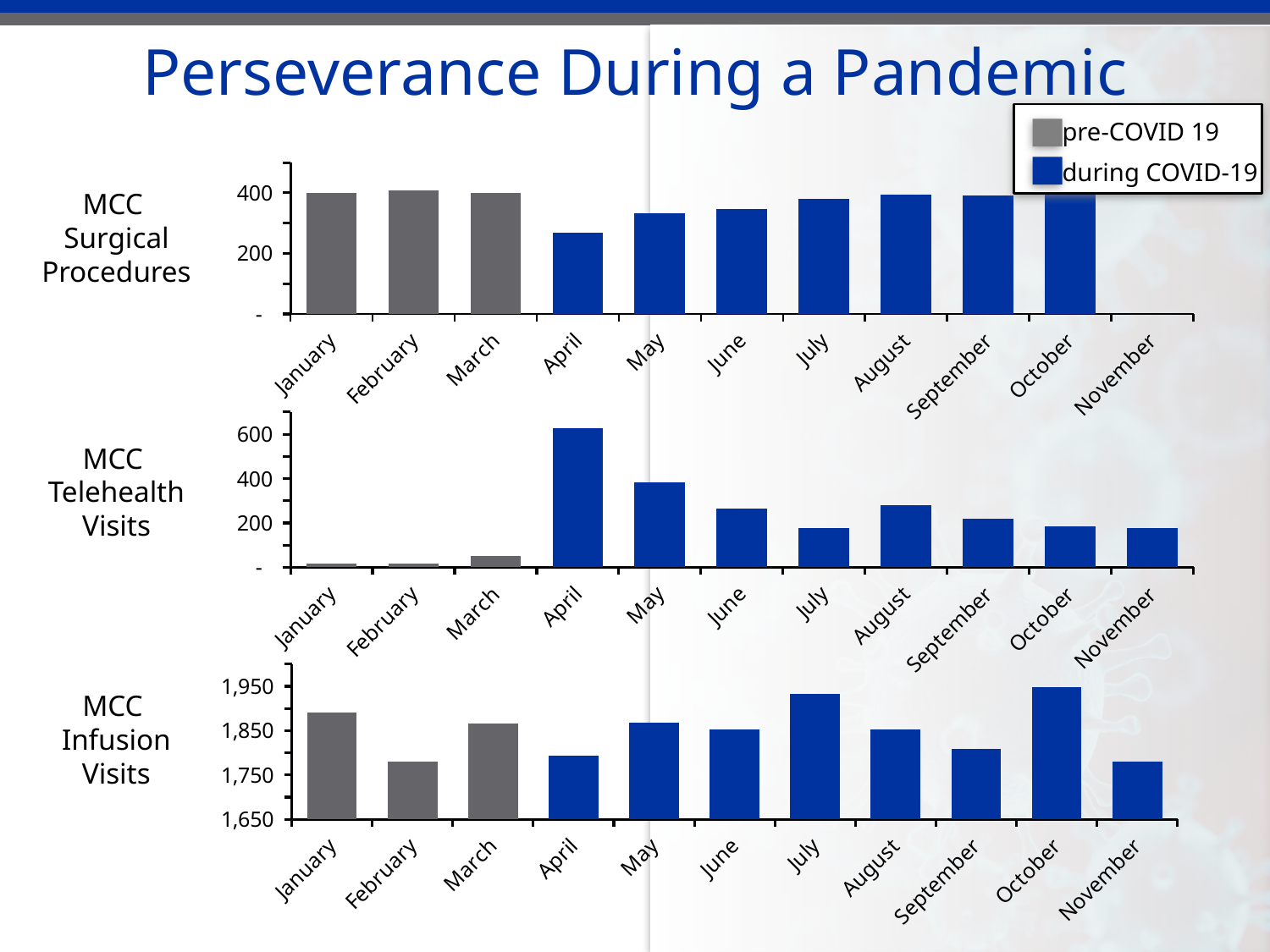
How many series does the legend list? 2 In the MCC Surgical Procedures chart, is the value for April greater or less than 400? less In the MCC Telehealth Visits chart, which month has the highest value? April In the MCC Telehealth Visits chart, which is larger, the value for April or the value for May? April How many months are shown on the x axis of the MCC Telehealth Visits chart? 11 In the MCC Surgical Procedures chart, which month has the lowest value among the months with bars? April In the MCC Telehealth Visits chart, is the value for April greater or less than 400? greater In the MCC Surgical Procedures chart, do the values rise or fall from April to October? rise Which colour represents the 'during COVID-19' series in the legend? blue In the MCC Infusion Visits chart, is the value for February greater or less than 1,850? less What kind of chart is the MCC Surgical Procedures chart? bar chart